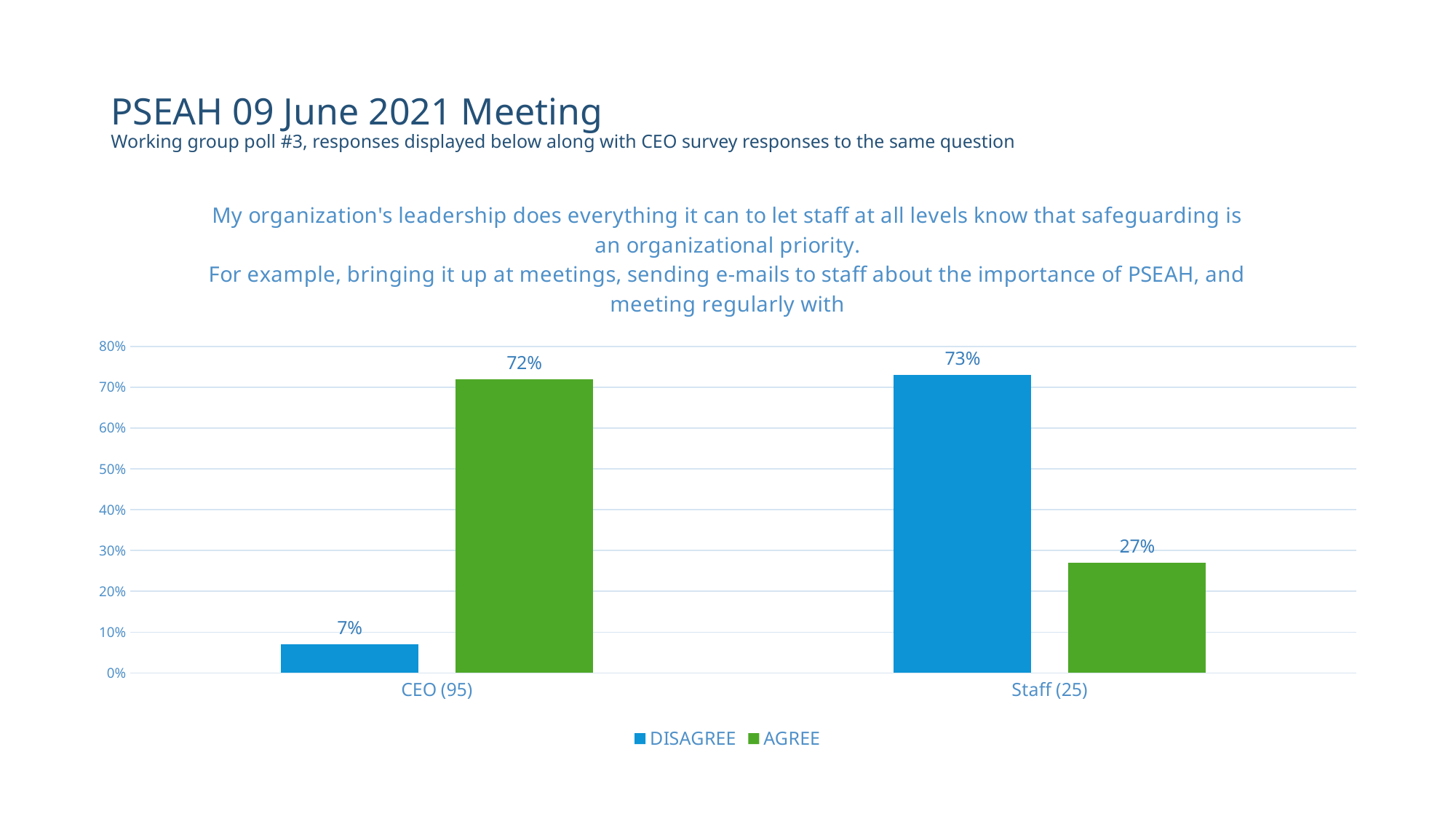
Which category has the lowest DISAGREE value? CEO (95) What kind of chart is shown on the slide? Bar chart What is the AGREE value for CEO (95)? 72% What is the AGREE value for Staff (25)? 27% How many categories are shown on the x axis? 2 What is the difference between the AGREE values for CEO (95) and Staff (25)? 45% Which colour represents the AGREE series in the legend? Green How many series does the legend list? 2 What is the DISAGREE value for CEO (95)? 7% Which is larger: the DISAGREE value for Staff (25) or the AGREE value for Staff (25)? DISAGREE What is the DISAGREE value for Staff (25)? 73% Which category has the highest AGREE value? CEO (95)